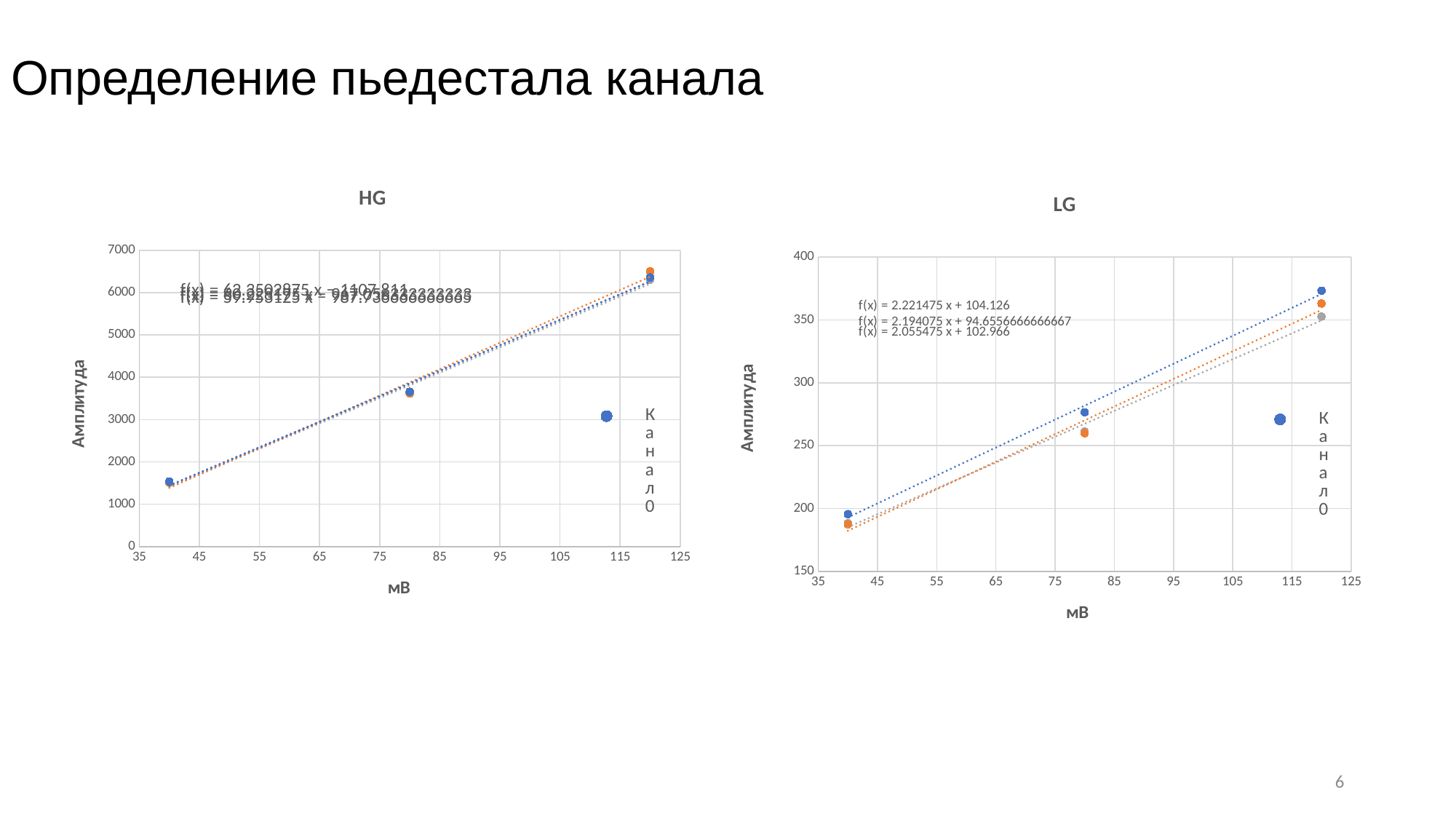
In the LG chart, how many distinct мВ values have data points plotted? 3 In the HG chart, is the amplitude at 40 мВ greater or less than 2000? less In the LG chart, is the amplitude at 120 мВ greater or less than 350? greater In the LG chart, what is the intercept in the first trendline equation f(x) = 2.221475 x + ...? 104.126 What kind of chart is the LG chart? scatter chart What kind of chart is the HG chart? scatter chart What is the label of the x axis on the HG chart? мВ In the LG chart, is the amplitude at 80 мВ greater or less than 250? greater In the HG chart, do the plotted values rise or fall as мВ increases? rise In the LG chart, do the plotted values rise or fall as мВ increases? rise